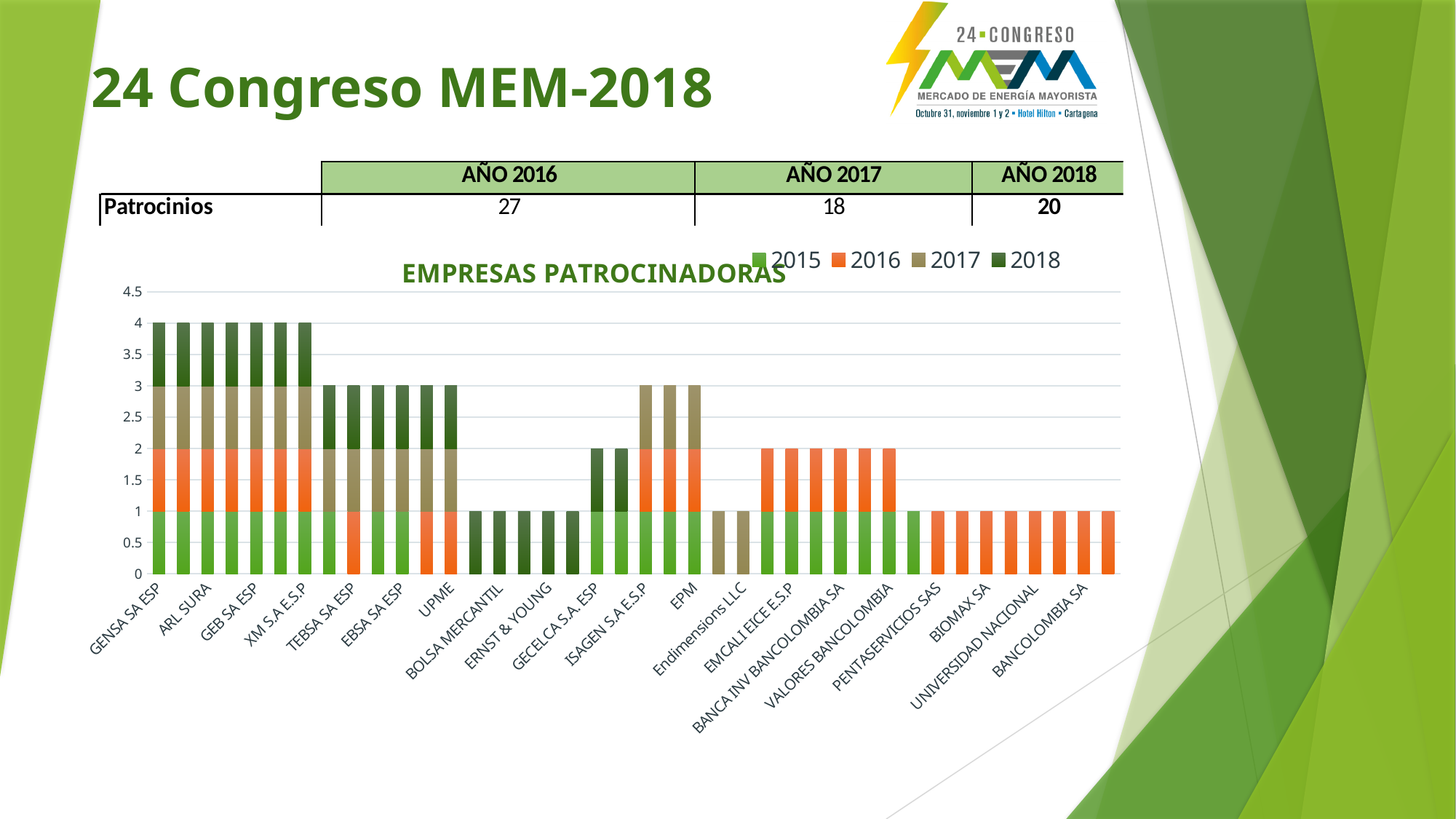
What kind of chart is shown under the title EMPRESAS PATROCINADORAS? Stacked bar chart What is the total stacked value for GENSA SA ESP in the EMPRESAS PATROCINADORAS chart? 4 What is the highest total reached by any stacked bar in the EMPRESAS PATROCINADORAS chart? 4 In the EMPRESAS PATROCINADORAS chart, which series is shown in orange? 2016 What is the lowest total of any stacked bar in the EMPRESAS PATROCINADORAS chart? 1 What is the maximum value shown on the y axis of the EMPRESAS PATROCINADORAS chart? 4.5 Which years are listed in the legend of the EMPRESAS PATROCINADORAS chart? 2015, 2016, 2017, 2018 How many series does the legend of the EMPRESAS PATROCINADORAS chart list? 4 In the EMPRESAS PATROCINADORAS chart, is the total for GENSA SA ESP greater or less than 3? greater In the EMPRESAS PATROCINADORAS chart, which has the larger total, GENSA SA ESP or BANCOLOMBIA SA? GENSA SA ESP What is the total stacked value for BANCOLOMBIA SA in the EMPRESAS PATROCINADORAS chart? 1 Do the stacked bar totals in the EMPRESAS PATROCINADORAS chart generally rise or fall from left to right? fall